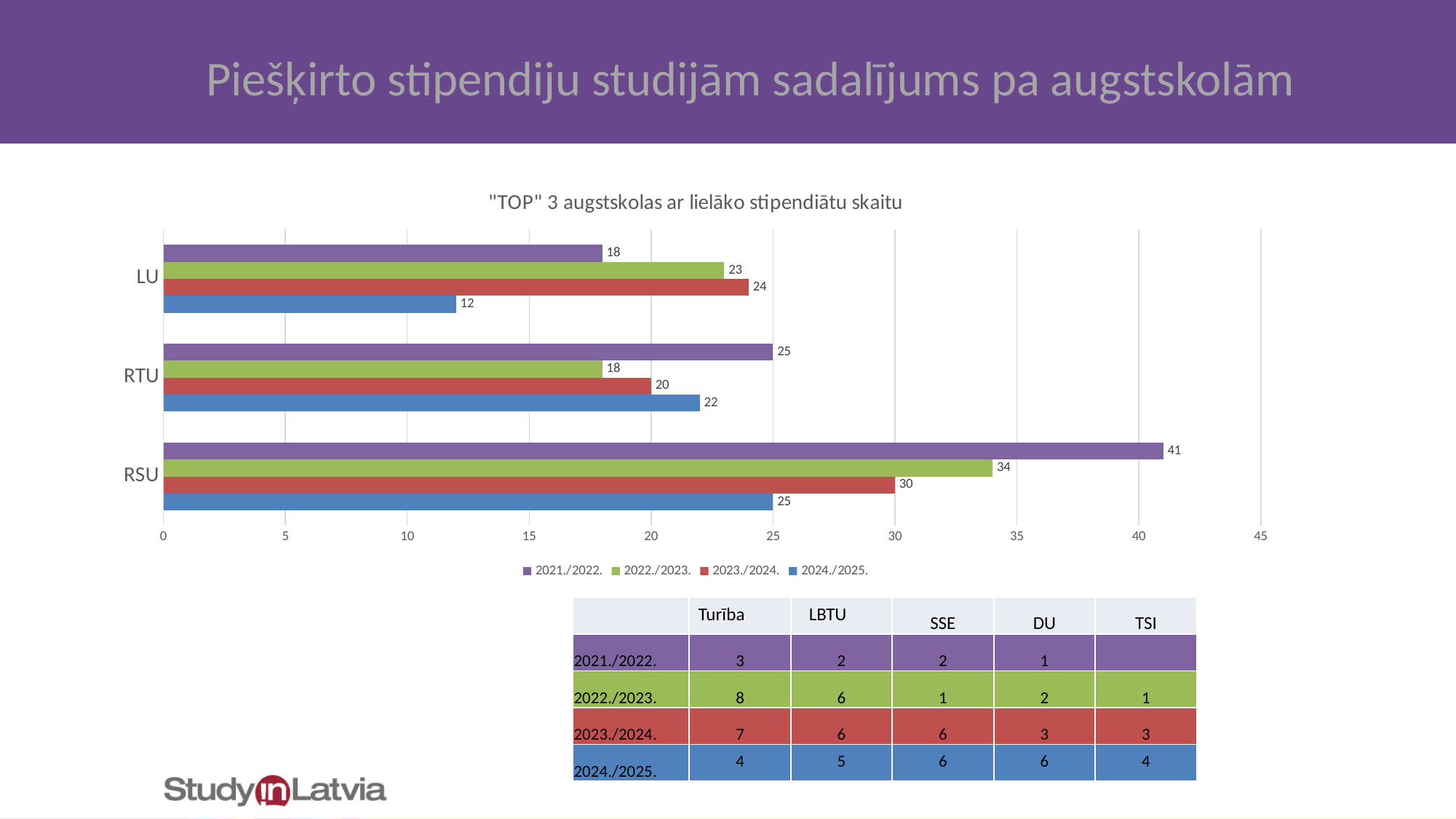
What kind of chart is shown? bar chart How many universities are shown on the chart? 3 Is the value for RSU in the 2022./2023. series greater or less than 30? greater Which university has the lowest value in the 2024./2025. series? LU What is the title of the chart? "TOP" 3 augstskolas ar lielāko stipendiātu skaitu What is the value for LU in the 2024./2025. series? 12 What is the value for RTU in the 2023./2024. series? 20 Which is larger: the LU value for 2023./2024. or the RTU value for 2023./2024.? LU What is the difference between the RSU and RTU values in the 2021./2022. series? 16 Which university has the highest value in the 2022./2023. series? RSU How many series does the legend list? 4 What is the value for RSU in the 2021./2022. series? 41